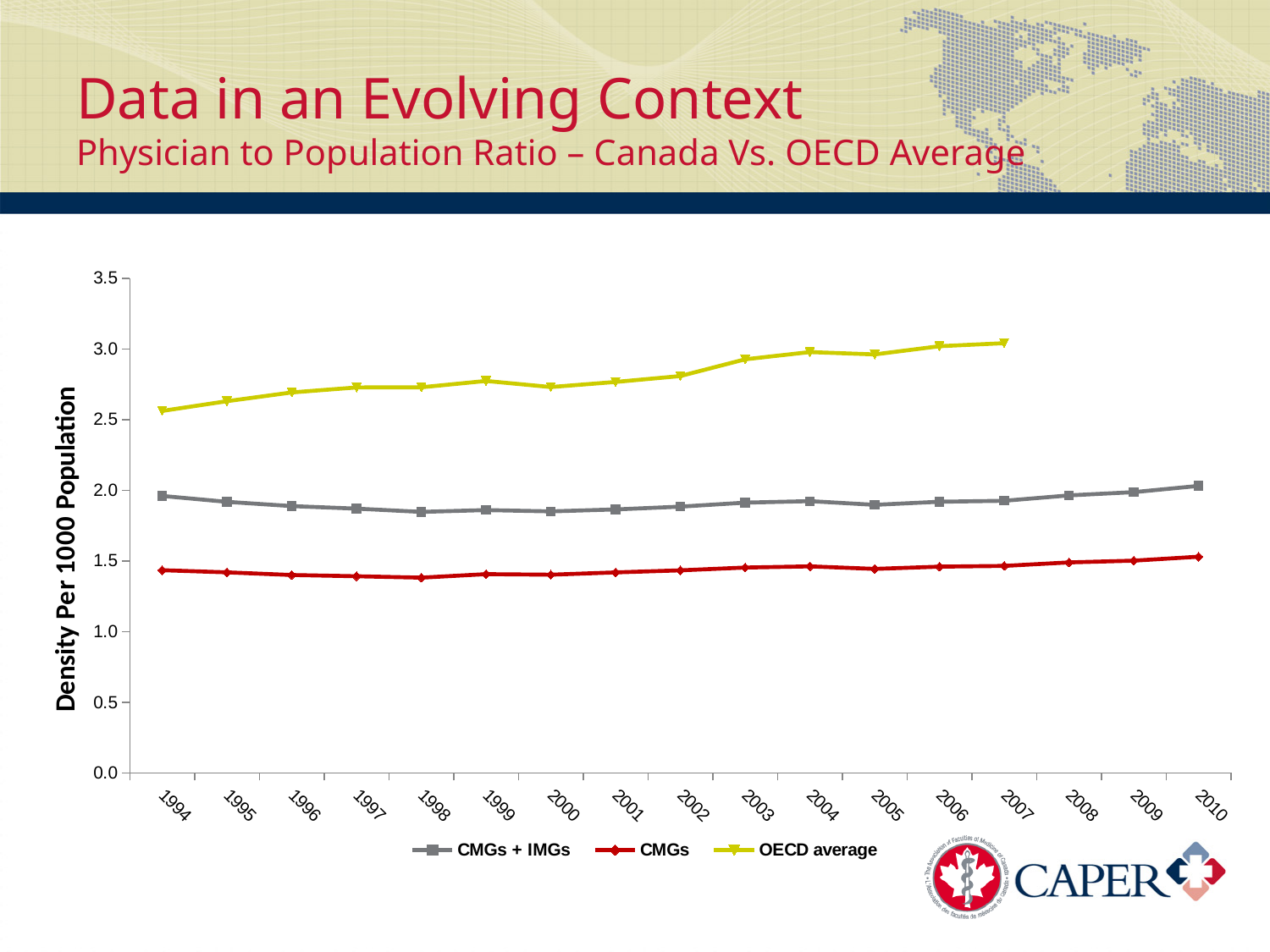
What is the label of the y axis? Density Per 1000 Population Is the value for CMGs + IMGs in 2000 greater or less than 1.5? greater Which series is plotted in yellow? OECD average Is the value for CMGs in 1998 greater or less than 1.5? less How many years are shown along the x axis? 17 What kind of chart is shown on the slide? Line chart Is the value for CMGs + IMGs in 1998 greater or less than 2.0? less How many series does the legend list? 3 Which series has the lowest values across all years? CMGs Does the OECD average line rise or fall from 1994 to 2007? rise Which series has the highest value in 2000? OECD average